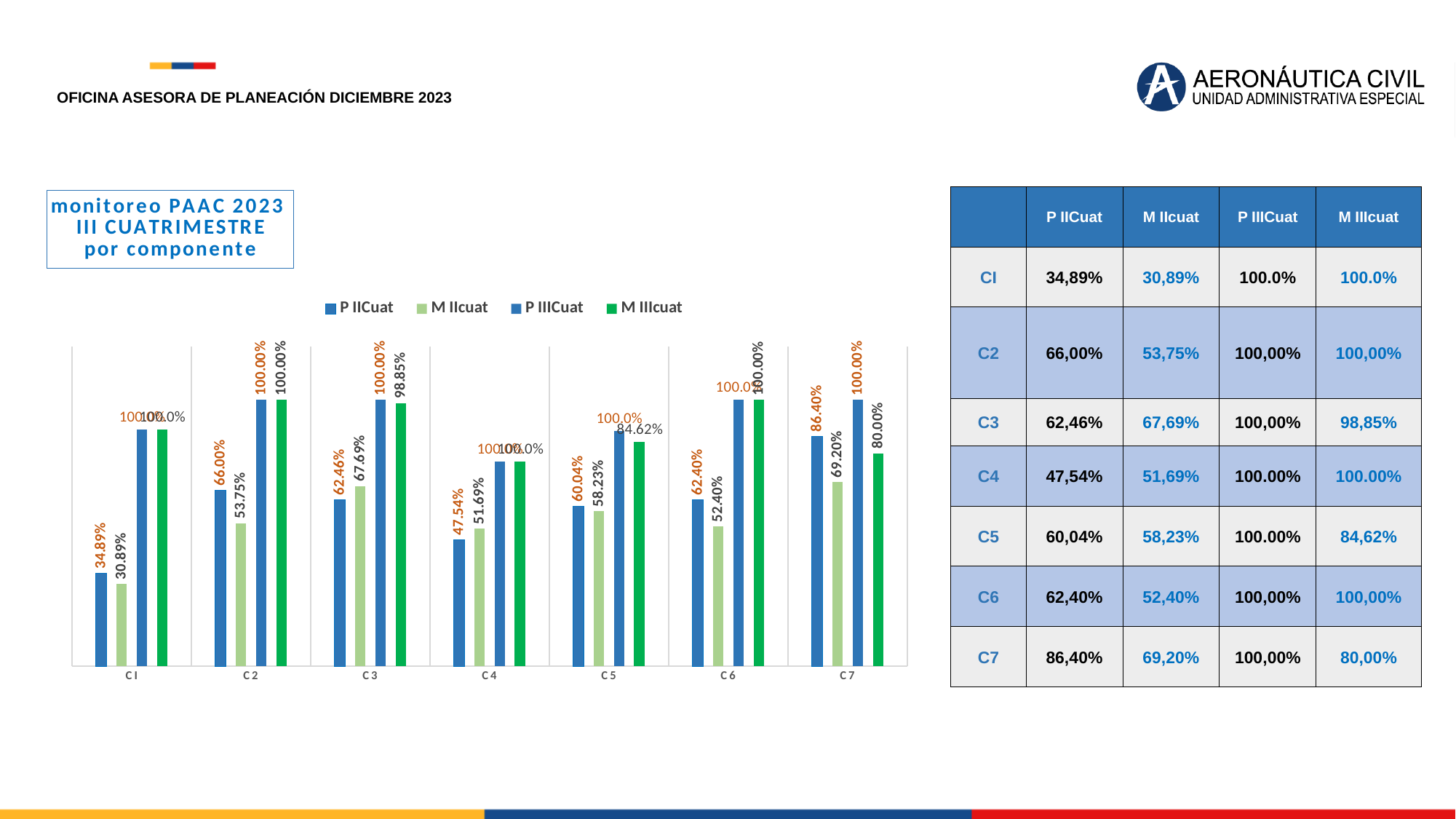
Which category has the highest P IICuat value? C7 For C4, which is larger: P IICuat or M IIcuat? M IIcuat How many categories are shown on the x axis of the chart? 7 What type of chart is shown on the slide? Bar chart Which category has the lowest M IIcuat value? C I What is the value of P IICuat for C7? 86.40% What is the value of M IIcuat for C3? 67.69% How many series does the chart legend list? 4 What is the value of M IIIcuat for C7? 80.00% What is the value of M IIIcuat for C5? 84.62% Which series is shown in green in the chart legend? M IIIcuat What is the difference between the P IICuat and M IIcuat values for C7? 17.20%